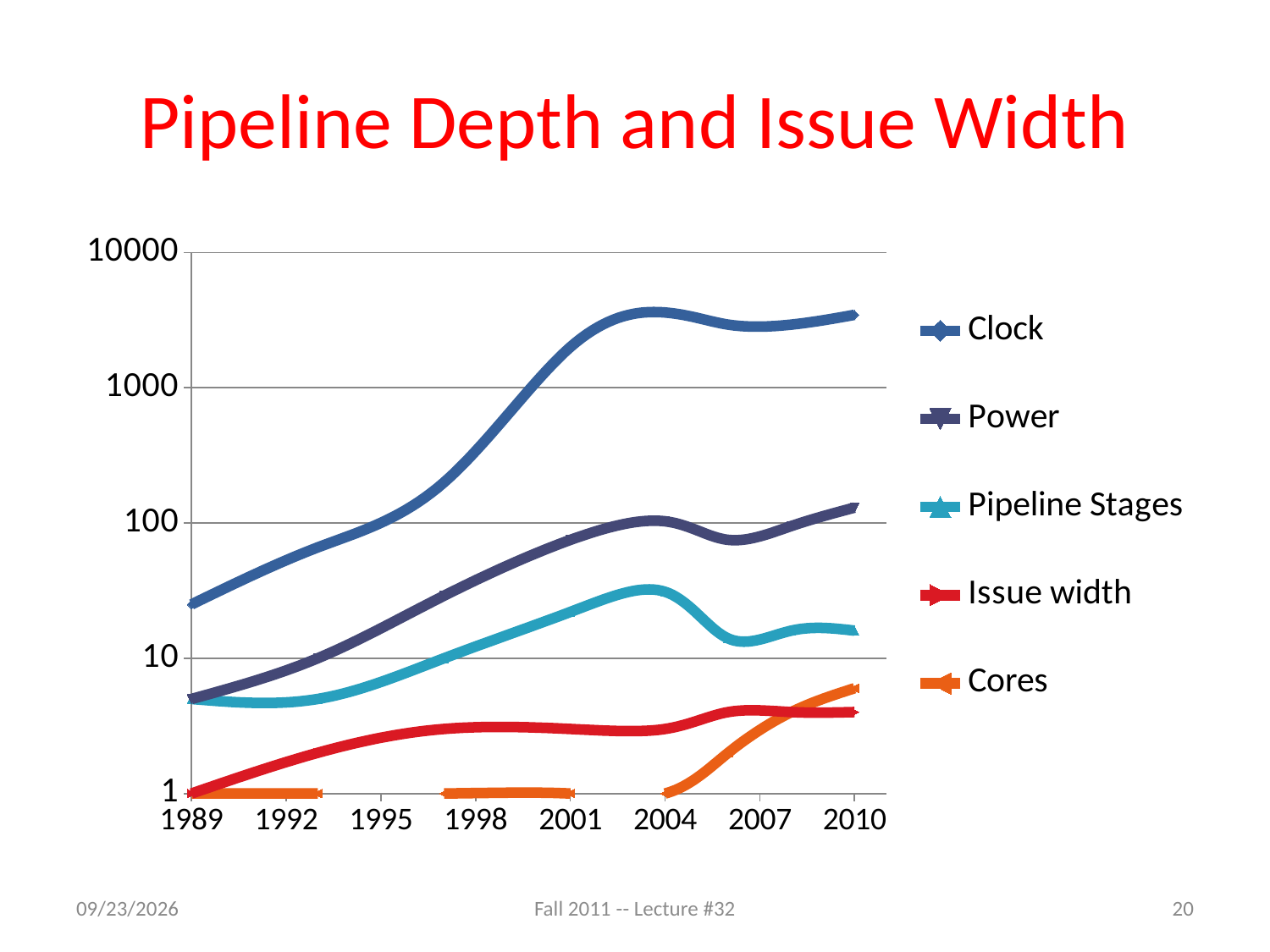
How many series does the legend list? 5 Which series is listed last in the legend? Cores What is the value for Cores in 1989? 1 What kind of chart is shown on the slide? line chart In 2010, which is larger, Clock or Power? Clock Is the value for Issue width in 2010 greater or less than 10? less Is the value for Clock in 2010 greater or less than 1000? greater Is the value for Pipeline Stages in 2004 greater or less than 10? greater What is the title of the slide containing the chart? Pipeline Depth and Issue Width Which series has the highest value in 2010? Clock Does the Clock series rise or fall from 1989 to 2004? rise